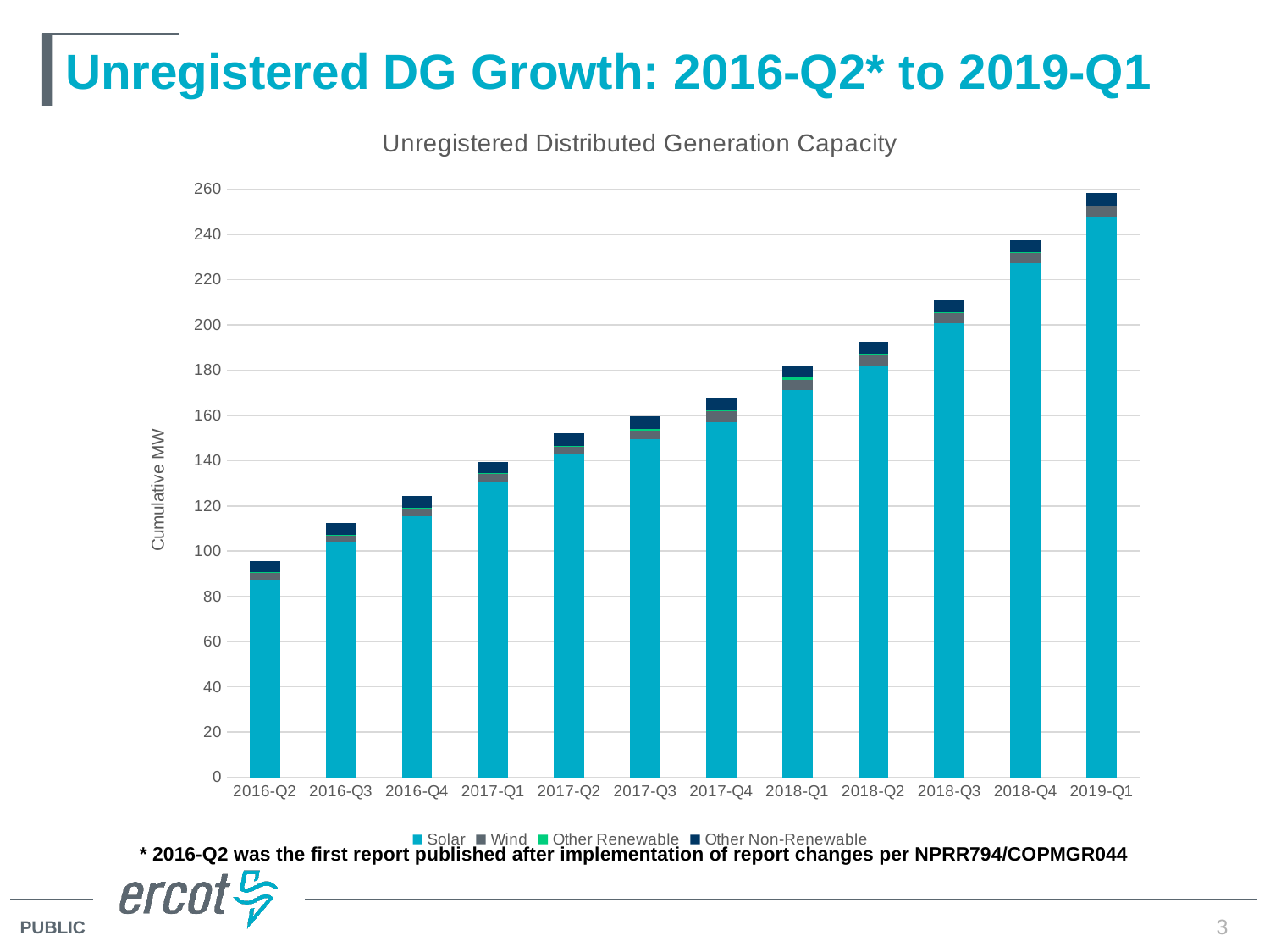
How many series does the legend list? 4 Is the total capacity for 2018-Q3 greater or less than 200 MW? greater Do the total bar heights rise or fall from 2016-Q2 to 2019-Q1? Rise Is the total capacity for 2019-Q1 greater or less than 240 MW? greater What is the label on the y axis of the chart? Cumulative MW Is the total capacity for 2017-Q2 greater or less than 140 MW? greater How many quarters (categories) are plotted along the x axis? 12 What kind of chart is shown on the slide? Stacked bar chart Which is larger, the total capacity for 2018-Q4 or for 2017-Q4? 2018-Q4 Which quarter has the lowest total unregistered distributed generation capacity? 2016-Q2 Which quarter has the highest total unregistered distributed generation capacity? 2019-Q1